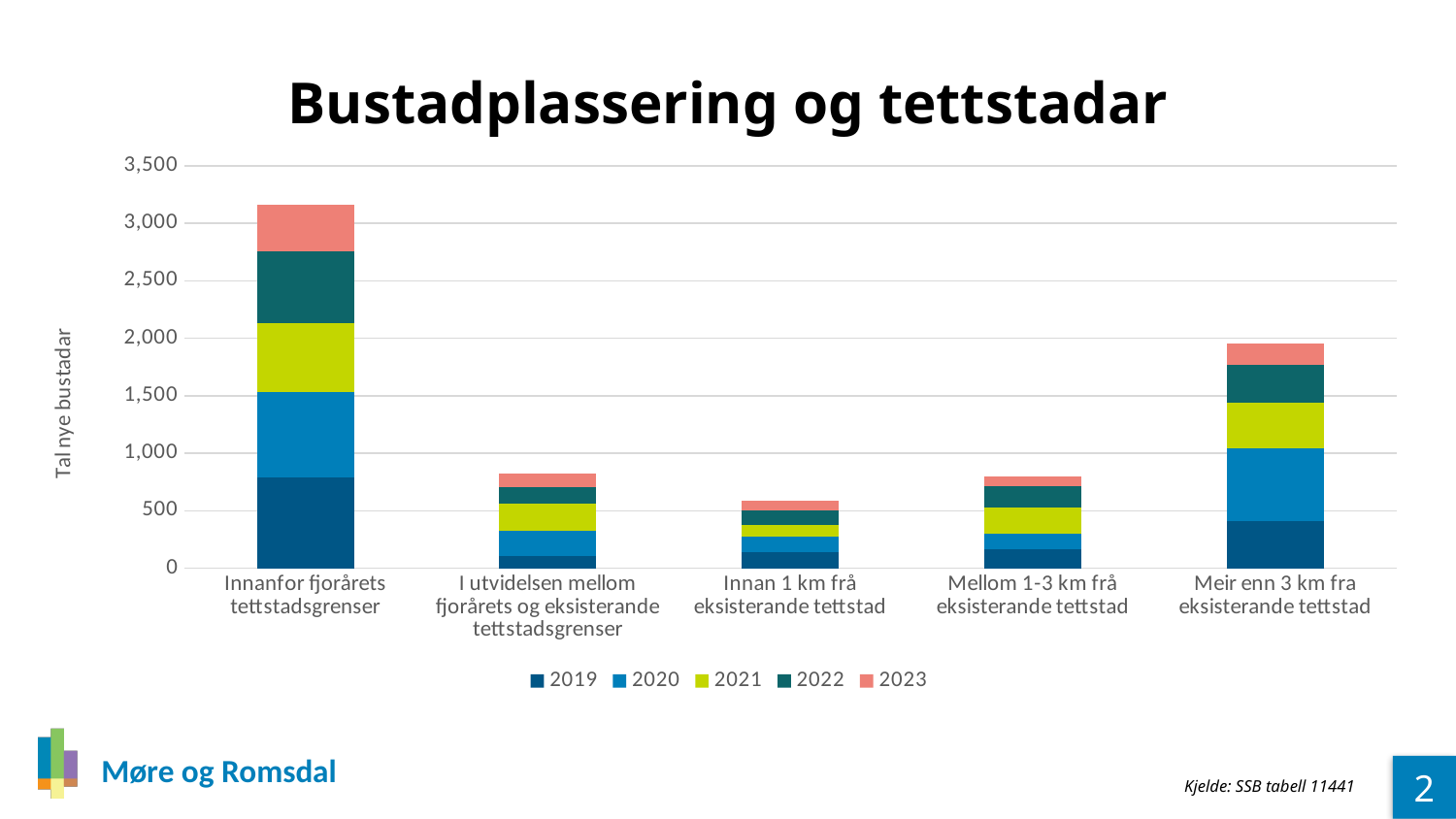
How many categories are shown along the x axis of the chart? 5 Which category has the shortest stacked bar in total? Innan 1 km frå eksisterande tettstad What is the label on the y axis of the chart? Tal nye bustadar Is the total stacked value for 'Innan 1 km frå eksisterande tettstad' greater or less than 1,000? less Which has the larger total stacked bar: 'Meir enn 3 km fra eksisterande tettstad' or 'I utvidelsen mellom fjorårets og eksisterande tettstadsgrenser'? Meir enn 3 km fra eksisterande tettstad What is the title of the chart? Bustadplassering og tettstadar Is the total stacked value for 'Mellom 1-3 km frå eksisterande tettstad' greater or less than 1,000? less How many series does the legend list? 5 Is the total stacked value for 'Innanfor fjorårets tettstadsgrenser' greater or less than 3,000? greater What kind of chart is shown on the slide? Stacked bar chart Which category has the tallest stacked bar in total? Innanfor fjorårets tettstadsgrenser